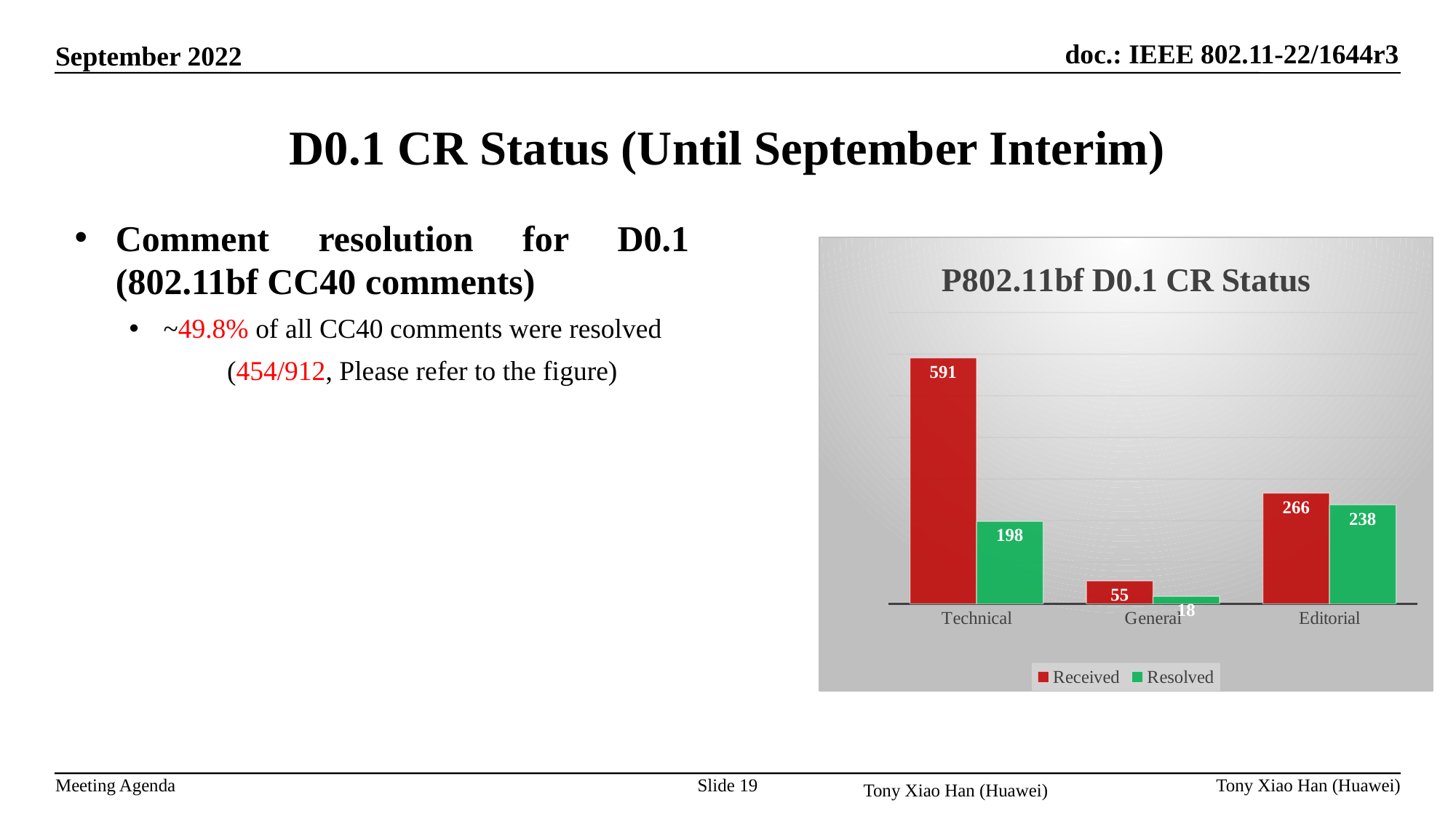
What is the Resolved value for Editorial? 238 Which category has the highest Received value? Technical How many categories are shown on the x axis? 3 What is the difference between Received and Resolved for Technical? 393 What is the Resolved value for General? 18 What kind of chart is shown on the slide? Bar chart What is the Received value for Technical? 591 What is the Received value for Editorial? 266 Which is larger for General: Received or Resolved? Received How many series does the legend list? 2 What is the difference between Received and Resolved for Editorial? 28 Which category has the lowest Resolved value? General